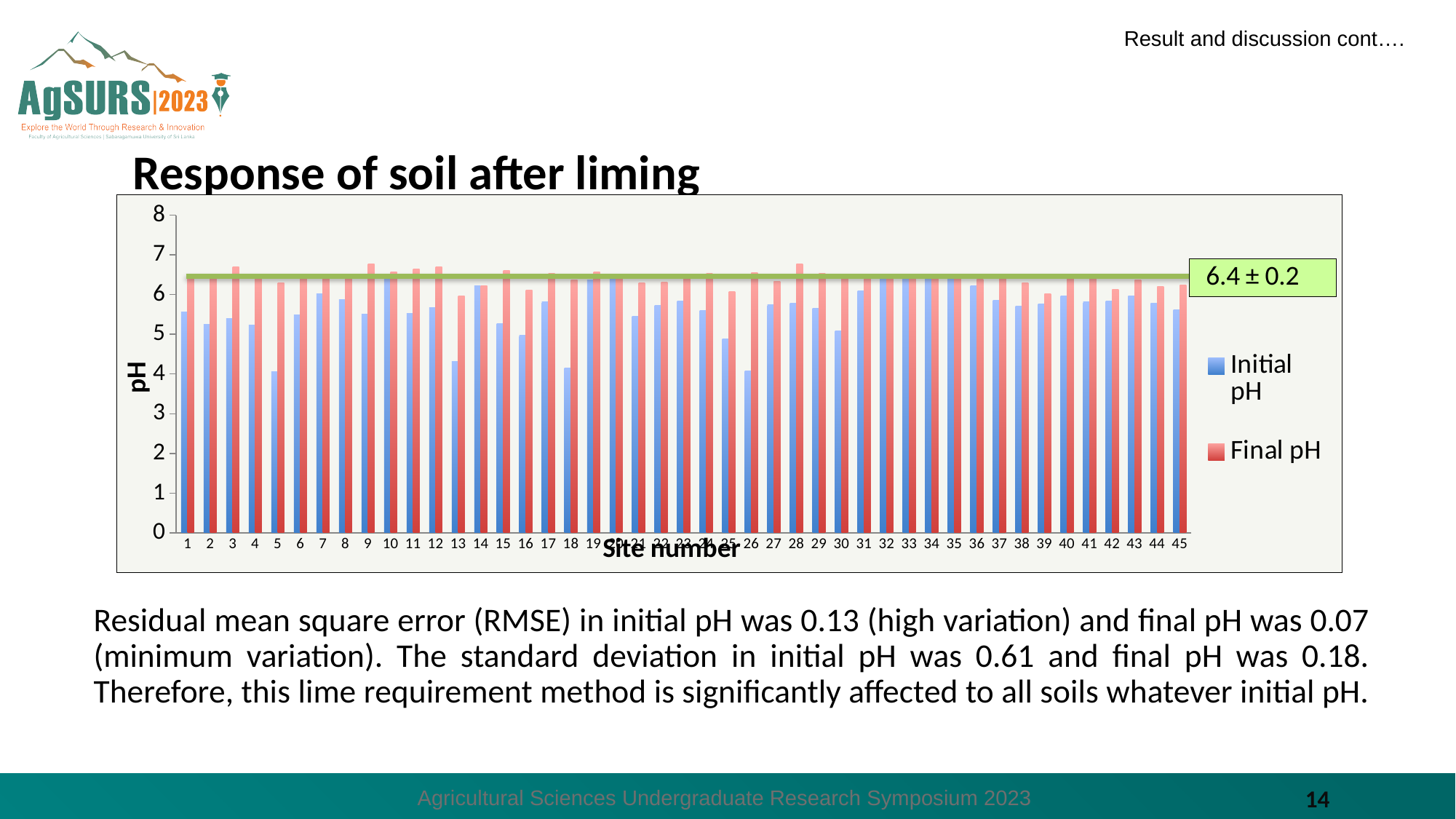
Is the Initial pH value for site 18 greater or less than 5? less For site 5, which is larger: the Initial pH or the Final pH? Final pH What value is shown in the green annotation box next to the horizontal line on the chart? 6.4 ± 0.2 Is the Initial pH value for site 5 greater or less than 5? less How many series does the chart legend list? 2 How many sites are plotted along the x axis of the chart? 45 Which series are listed in the chart legend? Initial pH and Final pH Is the Final pH value for site 9 greater or less than 6? greater What kind of chart is shown on the slide? Bar chart For site 13, which is larger: the Initial pH or the Final pH? Final pH